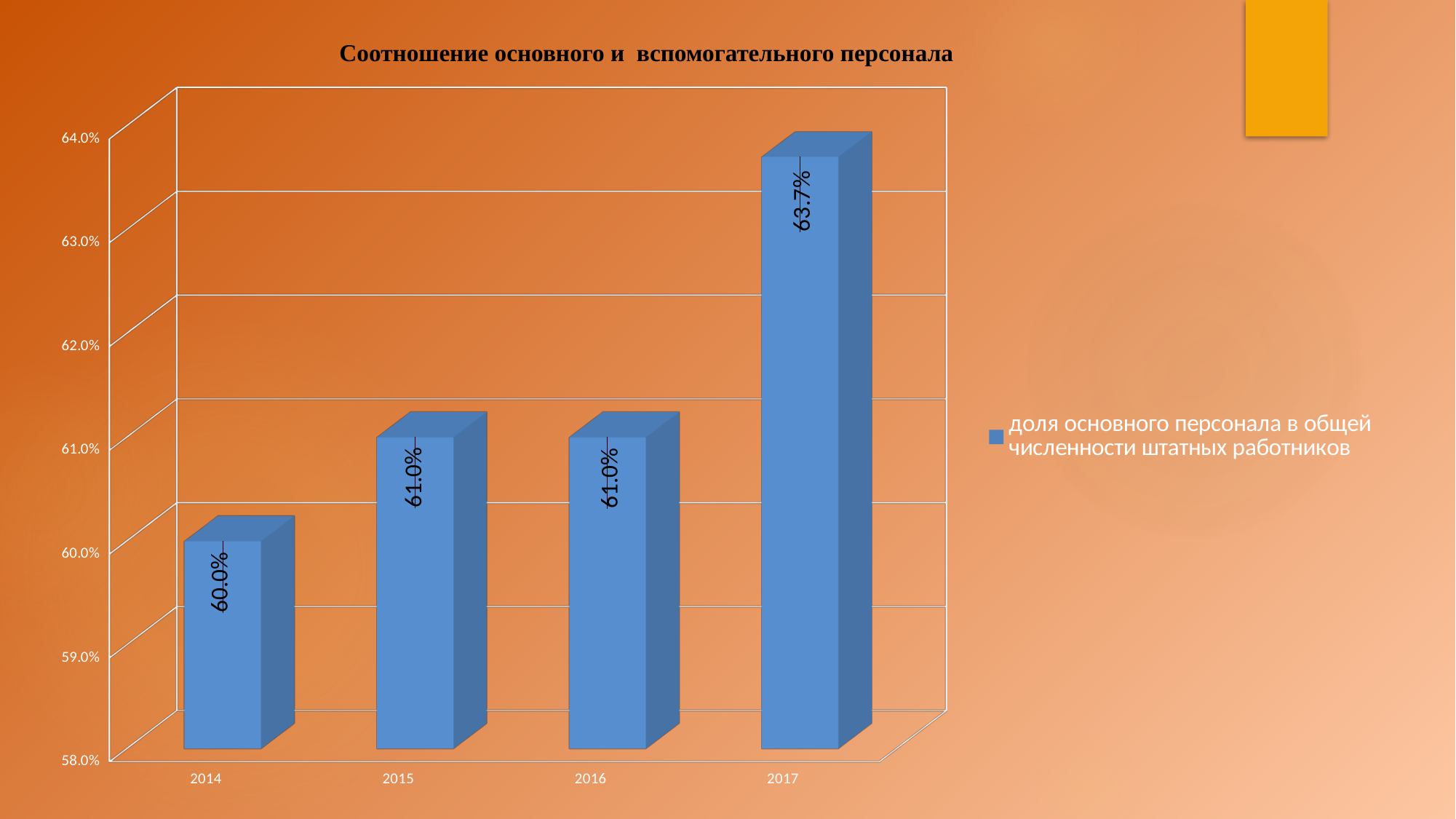
What is the title of the chart? Соотношение основного и вспомогательного персонала What is the difference between the values for 2015 and 2014? 1.0% How many series does the legend list? 1 What kind of chart is shown? bar chart What is the value for 2014? 60.0% What is the value for 2015? 61.0% Which year has the highest value? 2017 What is the difference between the values for 2017 and 2014? 3.7% Which year has the lowest value? 2014 Which is larger, the value for 2016 or the value for 2017? 2017 How many years are shown on the x axis? 4 What is the value for 2017? 63.7%